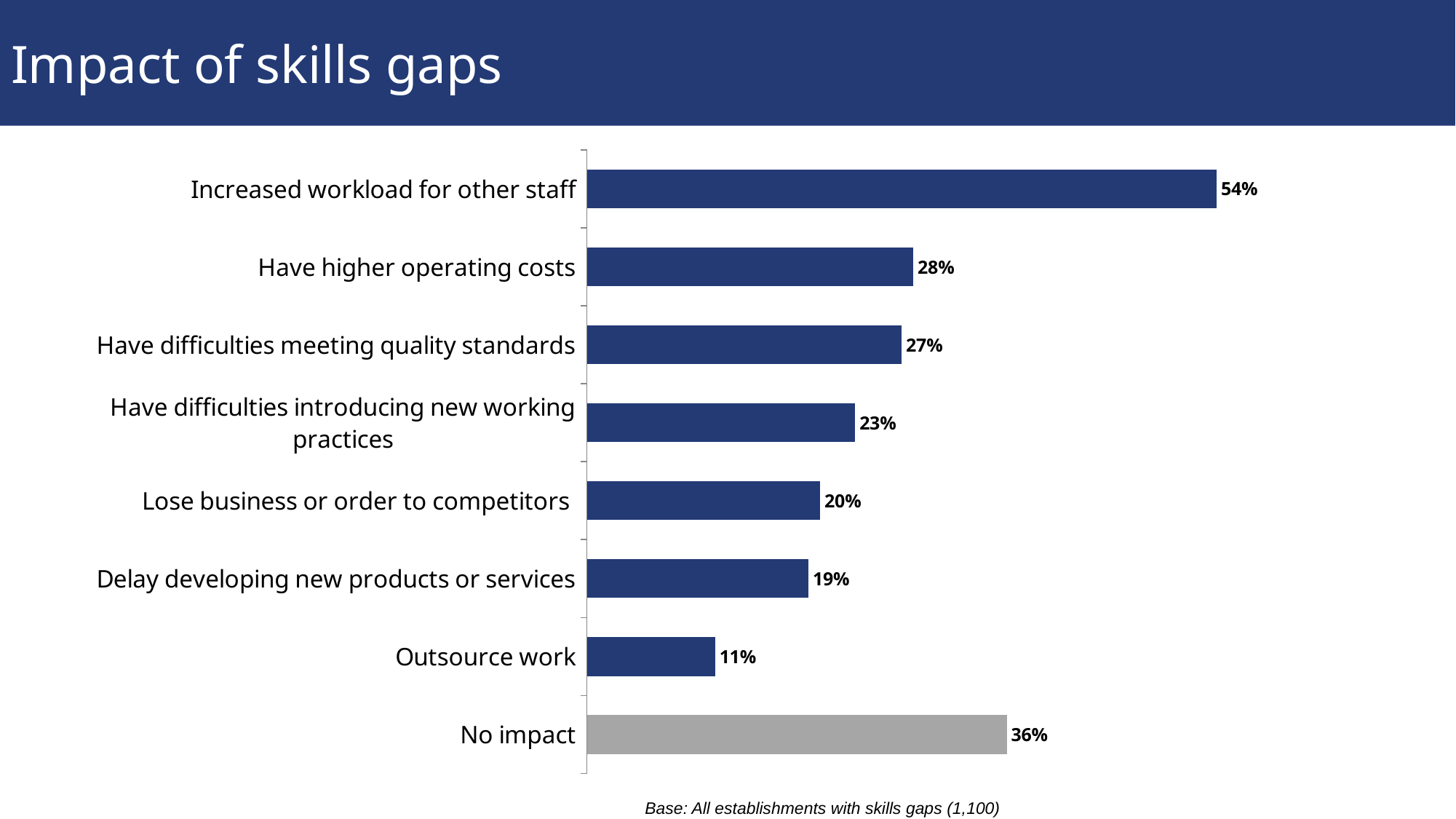
What kind of chart is shown on the slide? Bar chart What is the difference between 'Increased workload for other staff' and 'Have higher operating costs'? 26% What is the value for 'Outsource work'? 11% What percentage of establishments reported no impact from skills gaps? 36% What percentage of establishments reported increased workload for other staff? 54% Which bar is shown in a different colour (grey) from the others? No impact What is the value for 'Have difficulties introducing new working practices'? 23% What is the difference between 'No impact' and 'Outsource work'? 25% Which impact has the highest percentage? Increased workload for other staff How many categories are shown in the chart? 8 Which is larger: 'Lose business or order to competitors' or 'Delay developing new products or services'? Lose business or order to competitors Which category has the lowest percentage? Outsource work